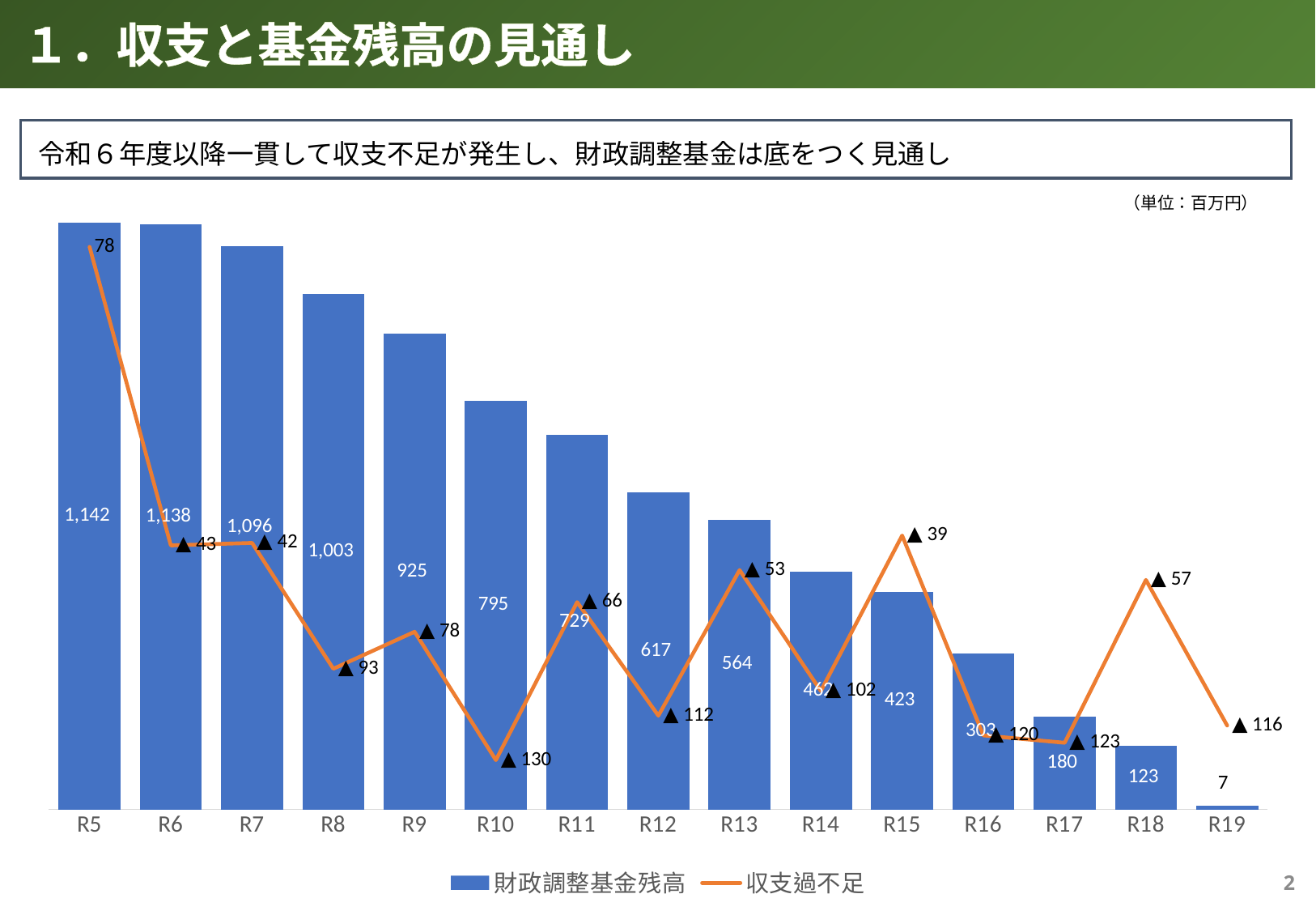
What is the value of 収支過不足 for R5? 78 Which is larger, the 財政調整基金残高 for R13 or for R14? R13 What is the value of 財政調整基金残高 for R10? 795 Which year has the lowest 財政調整基金残高? R19 Do the 財政調整基金残高 values rise or fall from R5 to R19? Fall What kind of chart is this? Combined bar and line chart How many years are shown on the x axis? 15 How many series does the legend list? 2 What is the difference between the 財政調整基金残高 for R5 and R6? 4 Which year has the highest 財政調整基金残高? R5 What is the value of 収支過不足 for R10? ▲ 130 What is the value of 財政調整基金残高 for R19? 7